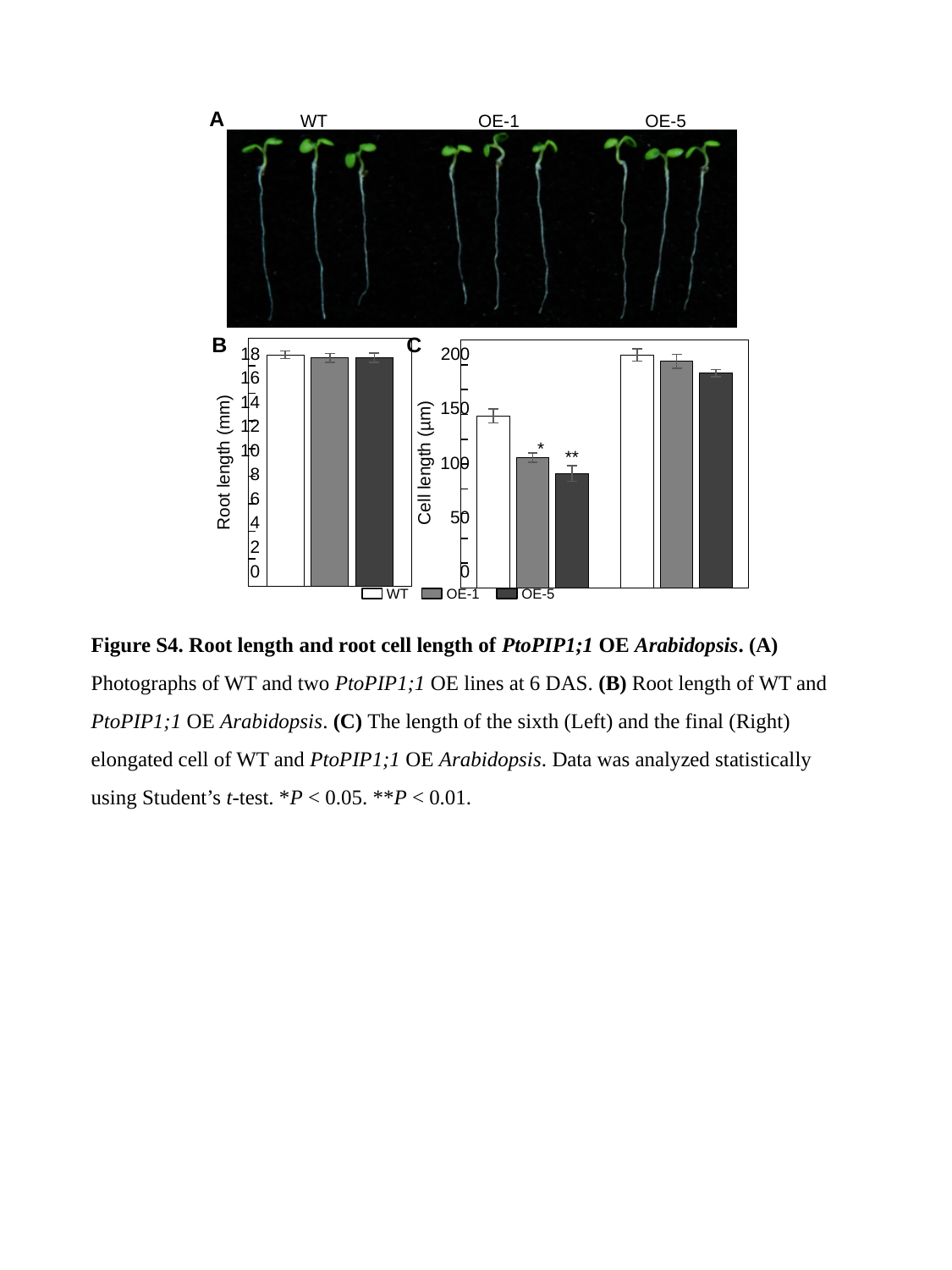
In chart B, is the WT bar greater or less than 16? greater What kind of chart is chart C (Cell length)? bar chart What kind of chart is chart B (Root length)? bar chart What is the y-axis title of chart C? Cell length (µm) In chart C, is the WT bar in the right group greater or less than 150? greater In chart C, is the WT bar in the left group greater or less than 100? greater What is the y-axis title of chart B? Root length (mm) In chart C, which series has the lowest bar in the left group? OE-5 In chart C, do the bars in the left group rise or fall going from WT to OE-1 to OE-5? fall How many series does the legend below the charts list? 3 In chart C, which series has the highest bar in the left group? WT